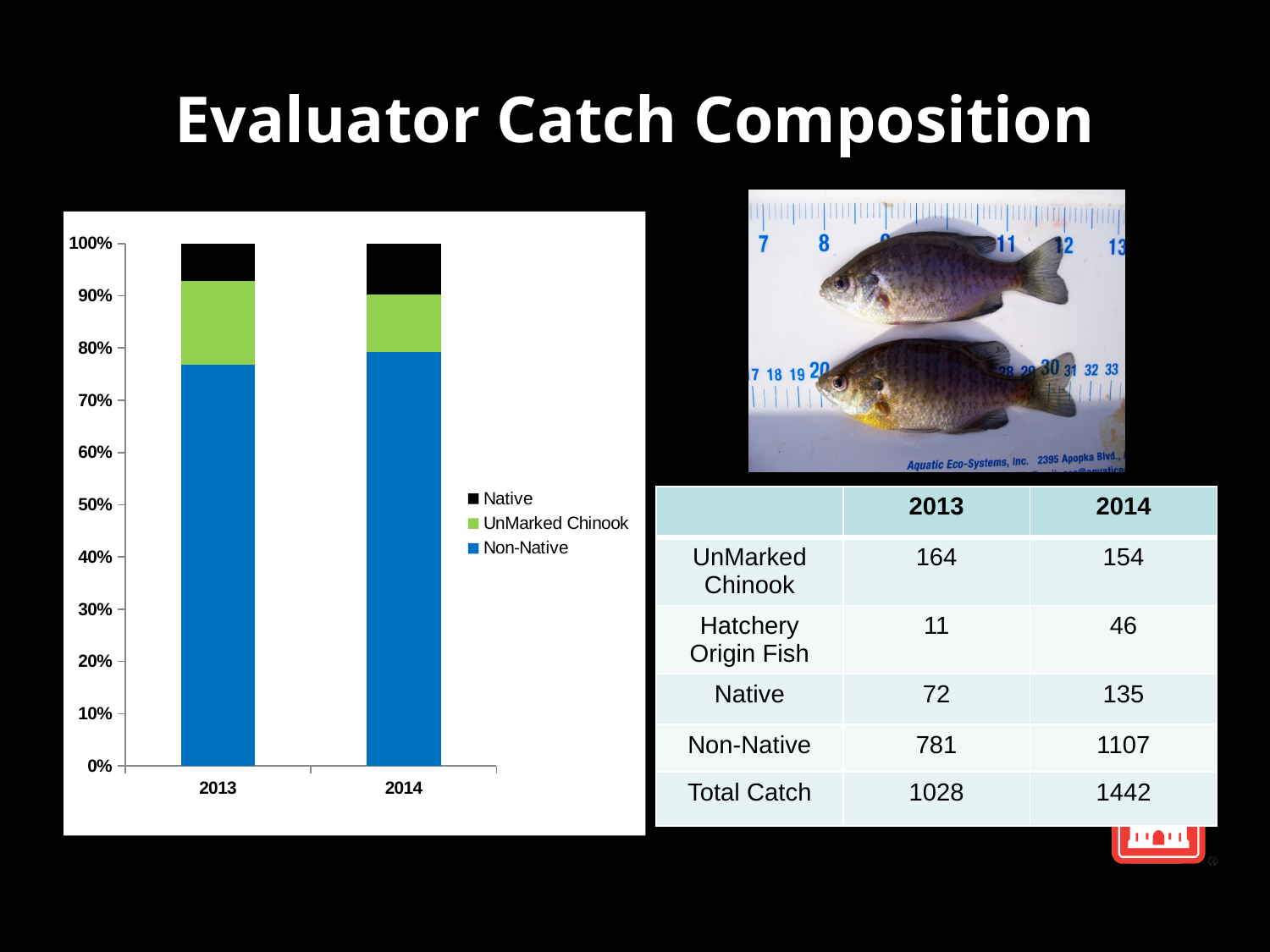
Is the top of the UnMarked Chinook segment in the 2013 bar above or below 90%? above Which series is shown in green in the chart? UnMarked Chinook What kind of chart is shown on the left of the slide? stacked bar chart Which series occupies the largest share of the 2014 bar? Non-Native In which year does the UnMarked Chinook segment take up a larger share of the bar, 2013 or 2014? 2013 How many categories are shown on the x axis of the chart? 2 Is the Non-Native share of the 2013 bar greater or less than 70%? greater How many series does the chart legend list? 3 Is the Non-Native share of the 2014 bar greater or less than 70%? greater What is the total height of each stacked bar in the chart? 100% Which series is shown in blue in the chart? Non-Native